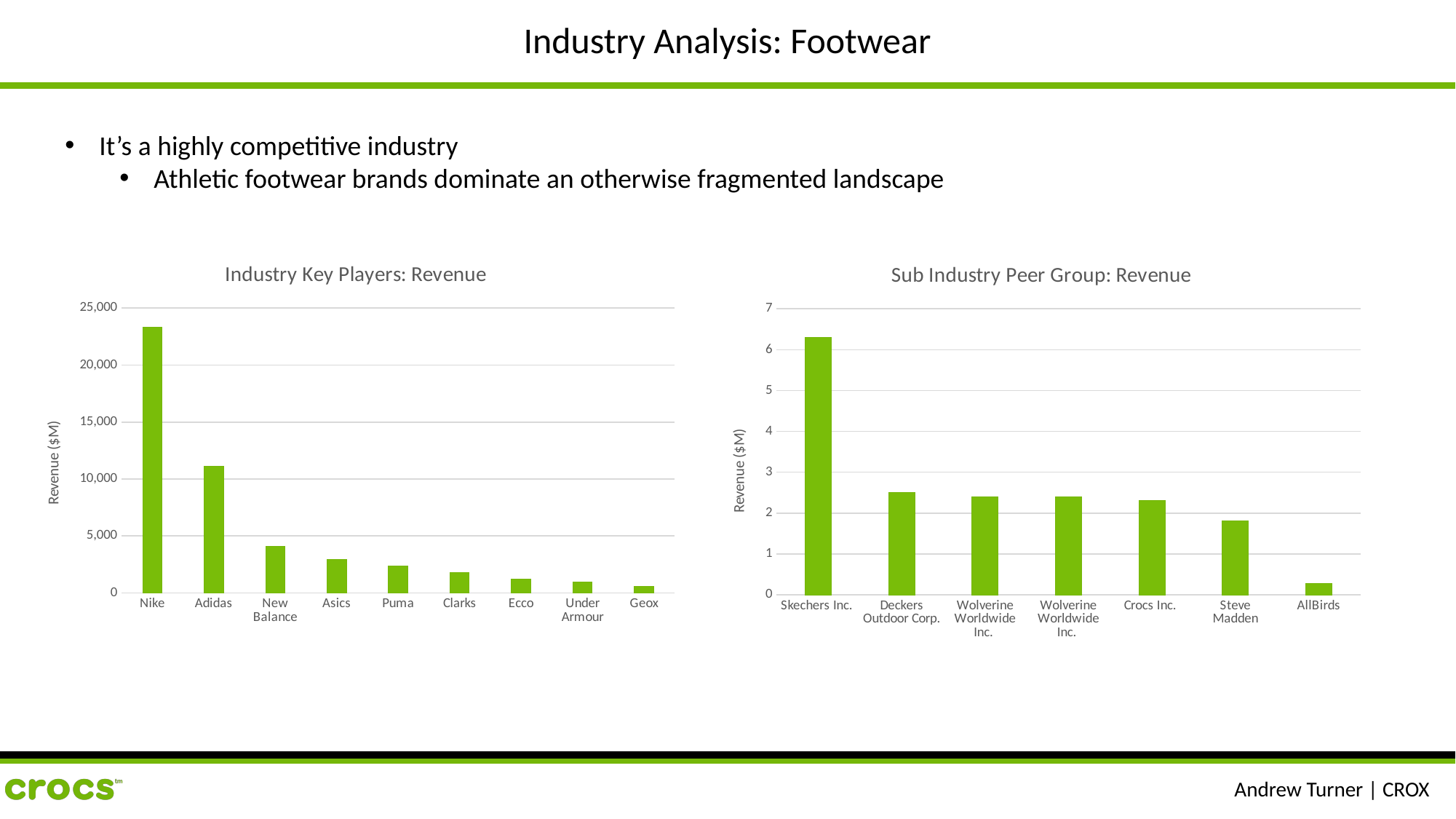
In the Industry Key Players: Revenue chart, which company has the highest revenue? Nike In the Industry Key Players: Revenue chart, is the value for Nike greater or less than 20,000? greater In the Industry Key Players: Revenue chart, which is larger, the revenue for Adidas or for New Balance? Adidas In the Industry Key Players: Revenue chart, is the value for New Balance greater or less than 5,000? less In the Sub Industry Peer Group: Revenue chart, is the value for Skechers Inc. greater or less than 6? greater How many companies are shown in the Industry Key Players: Revenue chart? 9 In the Industry Key Players: Revenue chart, do the values rise or fall from left to right along the x axis? fall In the Industry Key Players: Revenue chart, which company has the lowest revenue? Geox In the Sub Industry Peer Group: Revenue chart, which company has the lowest revenue? AllBirds What kind of chart is the Sub Industry Peer Group: Revenue chart? bar chart In the Sub Industry Peer Group: Revenue chart, which company has the highest revenue? Skechers Inc.